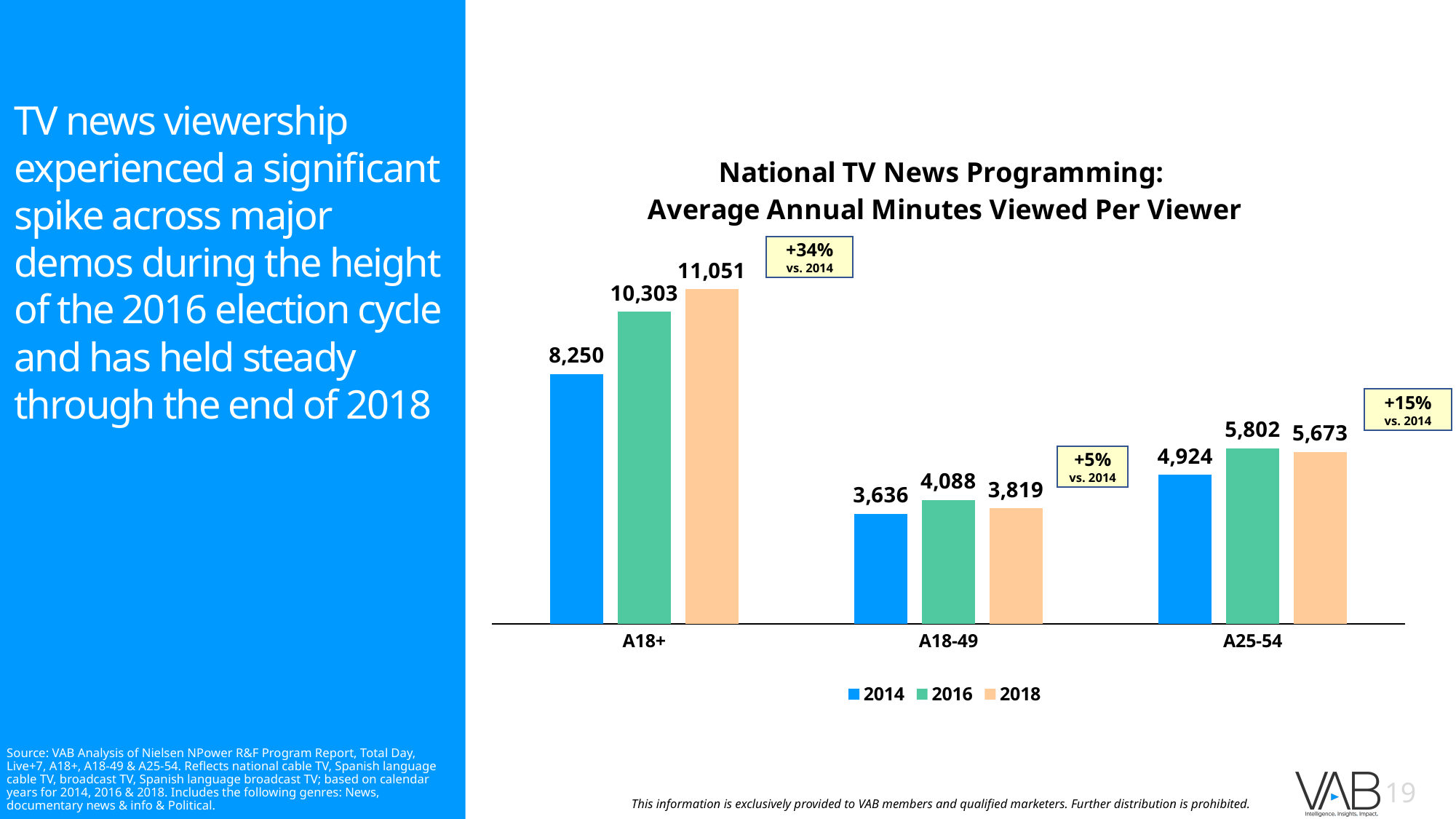
What is the value for A18-49 in 2016? 4,088 What is the difference between the 2018 and 2014 values for A18+? 2,801 How many series does the legend list? 3 How many demo categories are shown on the x axis? 3 What percentage change vs. 2014 is shown for A18-49? +5% Which demo has the lowest value in 2014? A18-49 For A25-54, which is larger: the 2016 value or the 2018 value? 2016 What is the value for A18+ in 2014? 8,250 What is the title of the chart? National TV News Programming: Average Annual Minutes Viewed Per Viewer Which demo has the highest value in 2018? A18+ What is the value for A25-54 in 2018? 5,673 What kind of chart is shown? Bar chart